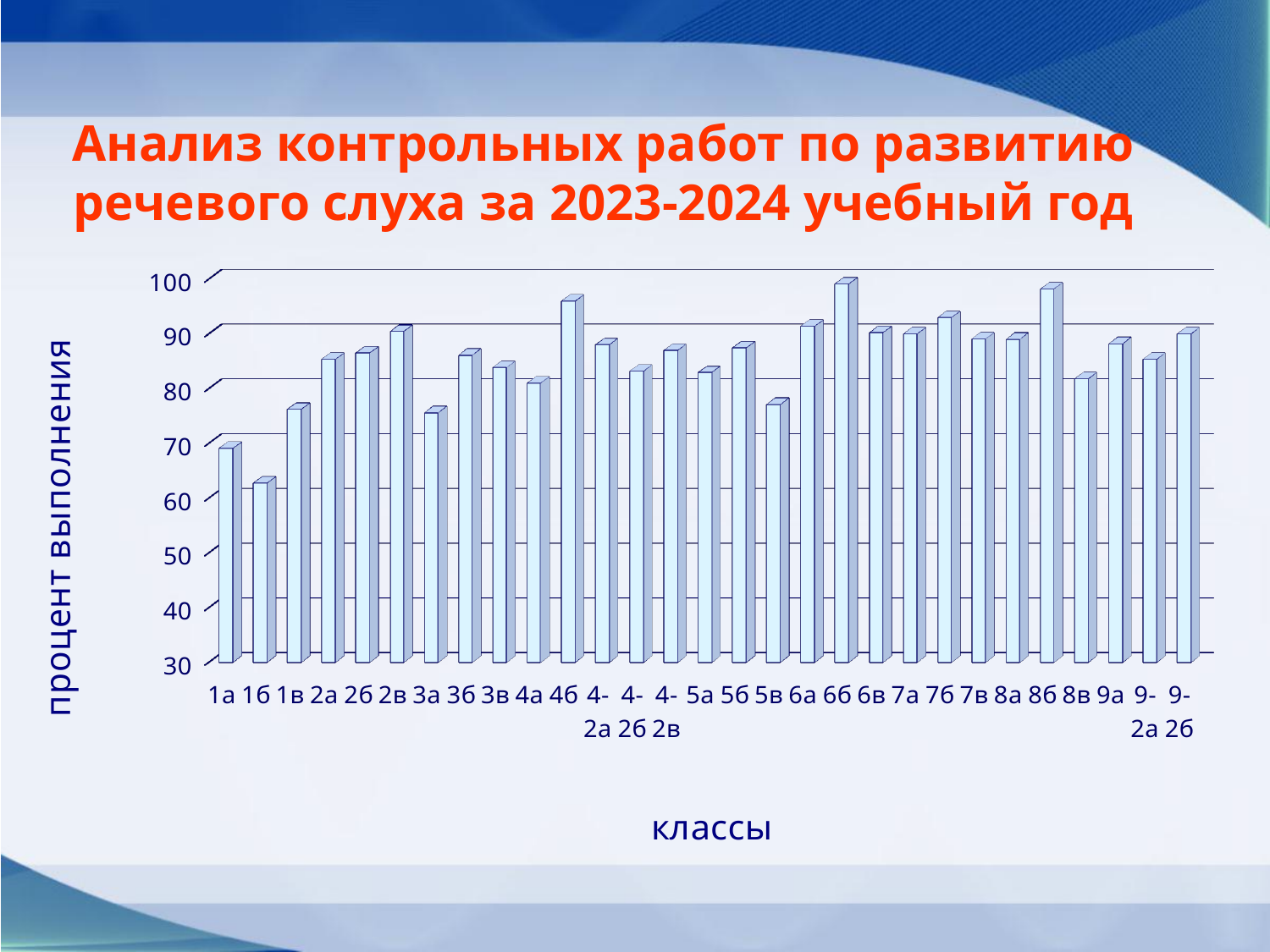
Is the value for class 6б greater or less than 90? greater Is the value for class 4б greater or less than 90? greater Which class has the larger value, 4а or 4б? 4б Is the value for class 1б greater or less than 70? less Which class has the lowest percentage of completion? 1б What kind of chart is shown on the slide? bar chart How many classes (categories) are plotted along the x axis? 29 Which class has the larger value, 1в or 1б? 1в What is the label of the vertical axis? процент выполнения